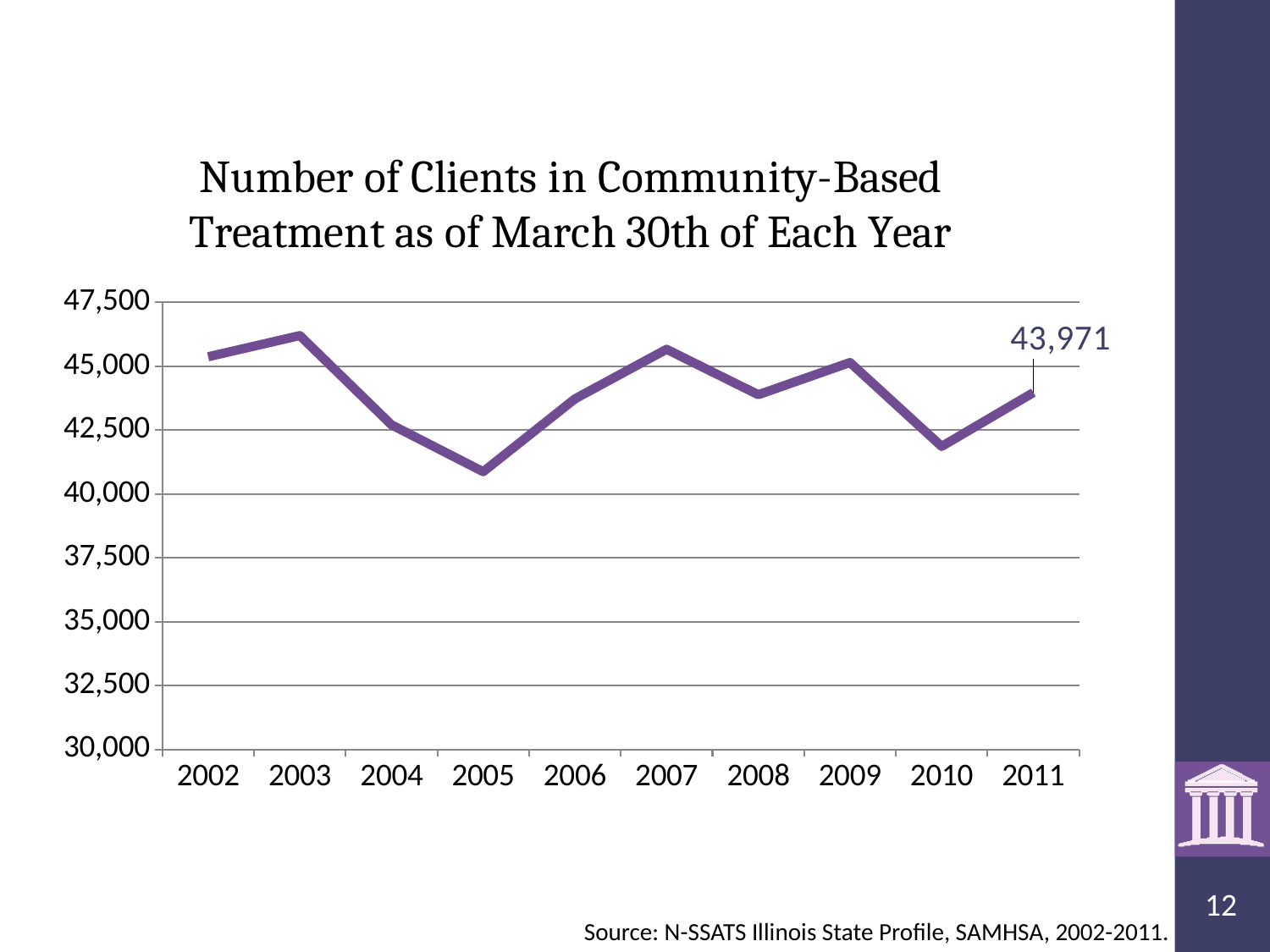
Which year has the larger value, 2003 or 2004? 2003 Is the value for 2008 greater or less than 45,000? less Is the value for 2010 greater or less than 42,500? less What is the title of the chart? Number of Clients in Community-Based Treatment as of March 30th of Each Year Is the value for 2003 greater or less than 45,000? greater Which year has the larger value, 2005 or 2010? 2010 What is the number of clients in community-based treatment in 2011? 43,971 What kind of chart is shown on the slide? line chart Which year has the lowest number of clients in community-based treatment? 2005 How many years are plotted on the chart? 10 Do the values rise or fall from 2003 to 2005? fall